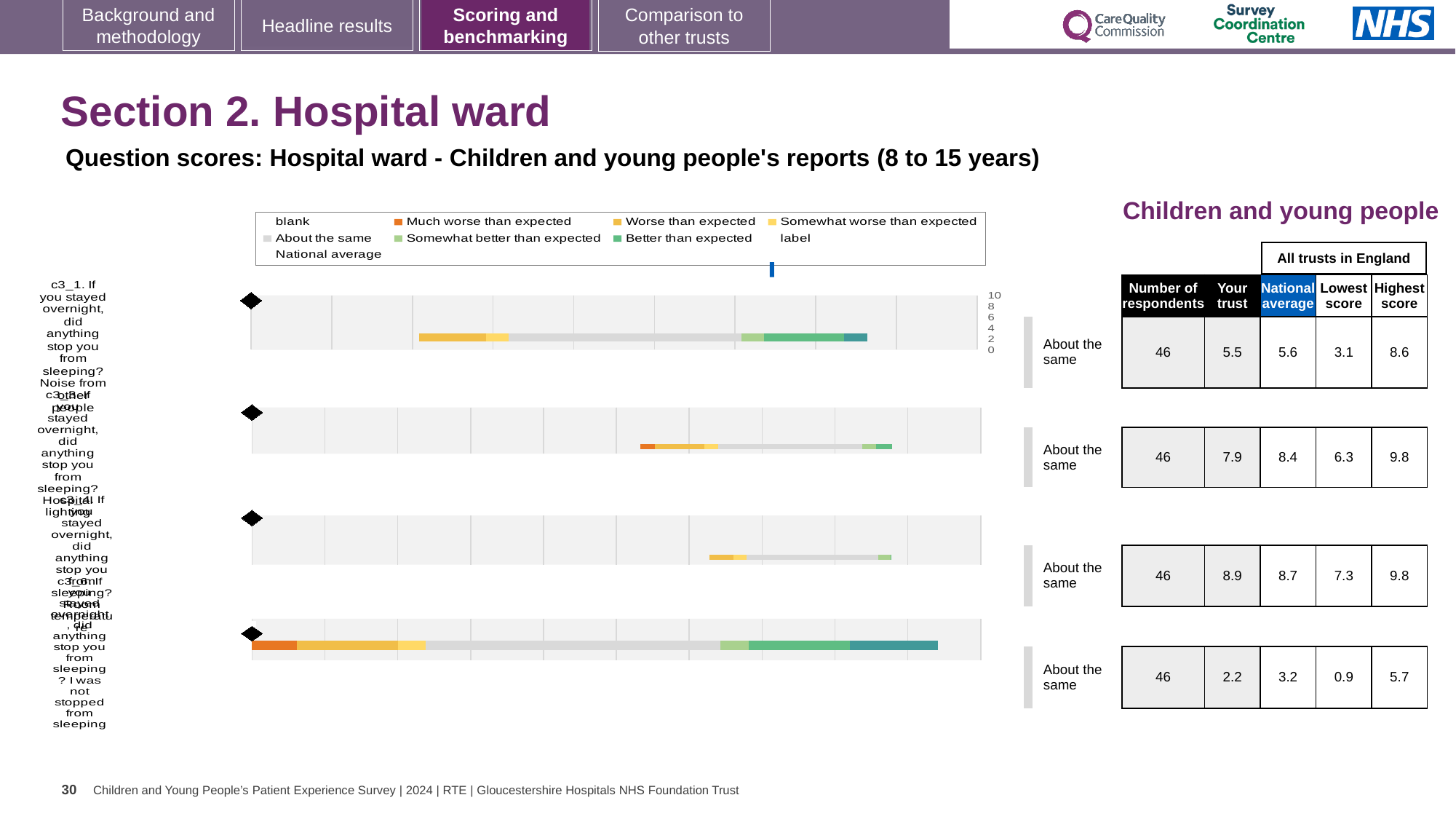
In the table beside the chart, what is the 'Your trust' score for the top (first) question row? 5.5 How many question rows (bars) are plotted in the chart? 4 What kind of chart is shown on the slide? bar chart How many respondents are listed for each question row in the table beside the chart? 46 In the table beside the chart, what is the National average for the second question row? 8.4 In the table beside the chart, what is the Lowest score for the third question row? 7.3 For the bottom (fourth) question row, what is the difference between the National average and the 'Your trust' score? 1.0 In the table beside the chart, what is the Highest score for the bottom (fourth) question row? 5.7 For the third question row, which is larger: the 'Your trust' score or the National average? Your trust (8.9) Which question row has the lowest 'Your trust' score in the table beside the chart? the bottom (fourth) row (2.2) What benchmark category is shown next to each of the four bars? About the same Which question row has the highest 'Your trust' score in the table beside the chart? the third row (8.9)